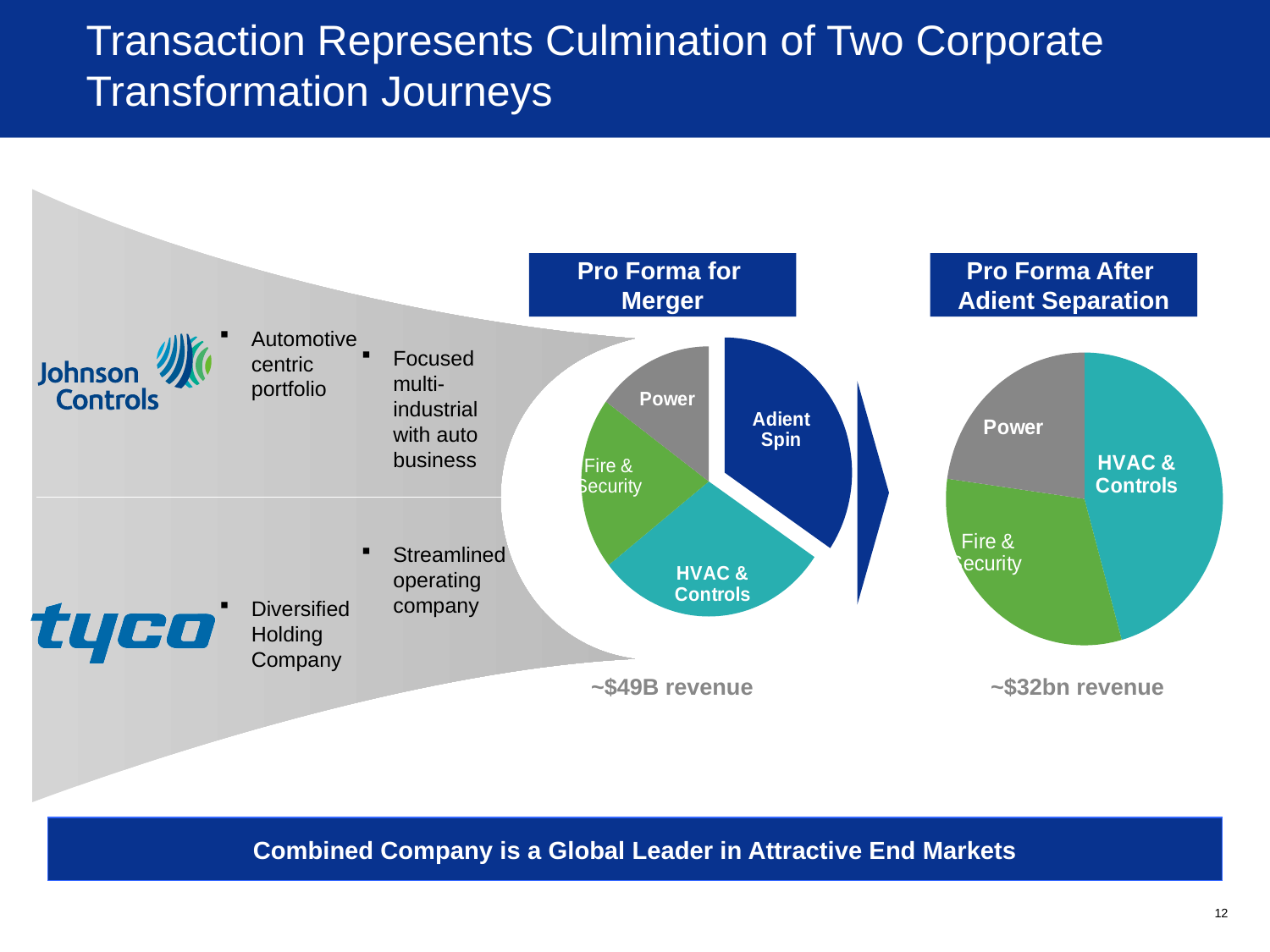
In the "Pro Forma for Merger" pie chart, which slice is the largest? Adient Spin What kind of chart is shown under the heading "Pro Forma After Adient Separation"? Pie chart In the "Pro Forma After Adient Separation" pie chart, how many slices are there? 3 What kind of chart is shown under the heading "Pro Forma for Merger"? Pie chart In the "Pro Forma After Adient Separation" pie chart, which slice is the smallest? Power In the "Pro Forma for Merger" pie chart, which slice is larger: Adient Spin or Power? Adient Spin What revenue caption is printed below the "Pro Forma After Adient Separation" pie chart? ~$32bn revenue In the "Pro Forma After Adient Separation" pie chart, which slice is the largest? HVAC & Controls In the "Pro Forma for Merger" pie chart, how many slices are there? 4 In the "Pro Forma After Adient Separation" pie chart, which slice is larger: HVAC & Controls or Power? HVAC & Controls Which slice is pulled out (exploded) from the "Pro Forma for Merger" pie chart? Adient Spin